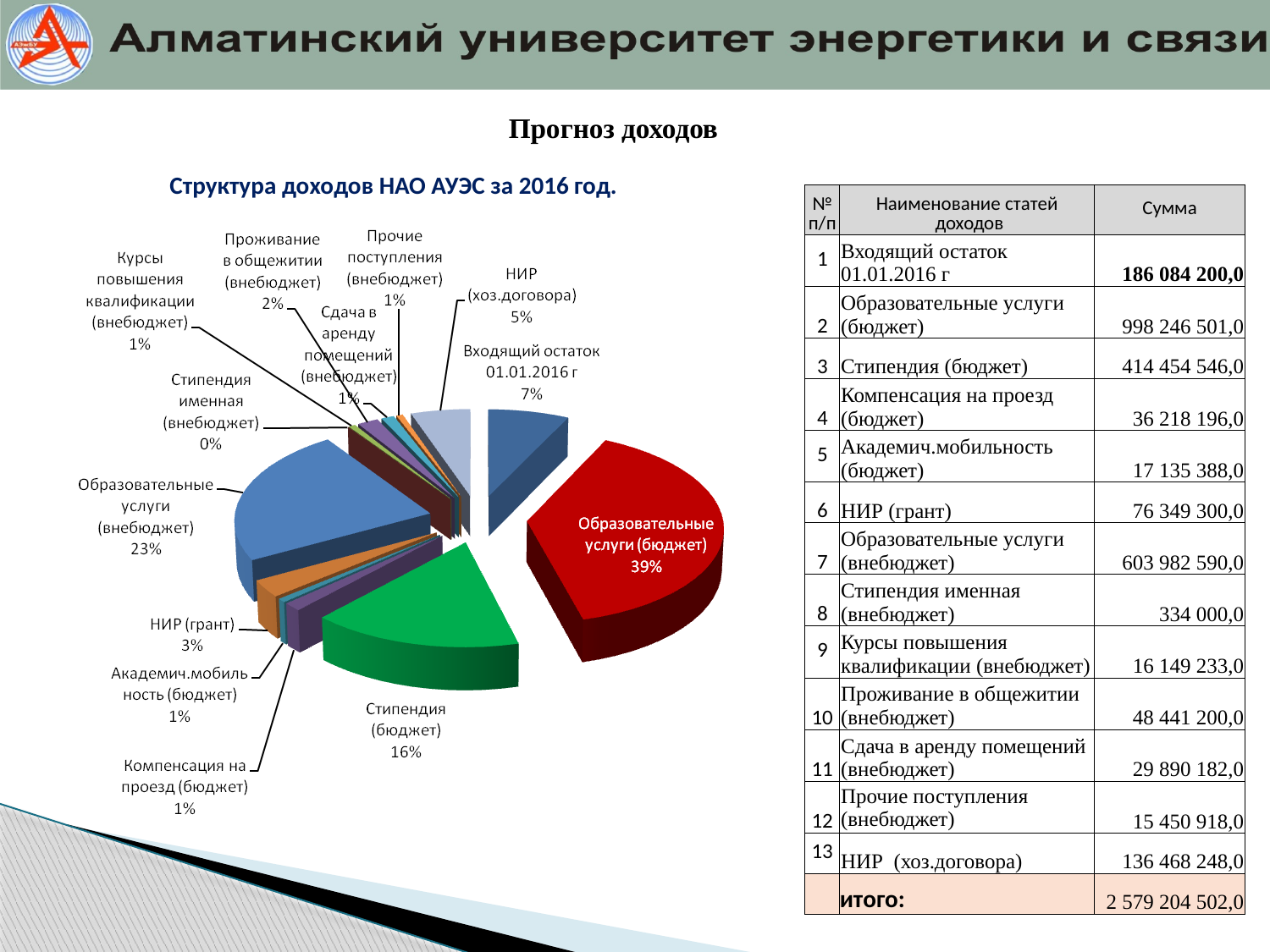
Which has the larger share: Стипендия (бюджет) or Образовательные услуги (внебюджет)? Образовательные услуги (внебюджет) Which slice of the pie is the smallest? Стипендия именная (внебюджет) What share of the pie does Образовательные услуги (бюджет) have? 39% What share of the pie does Образовательные услуги (внебюджет) have? 23% What is the title of the chart? Структура доходов НАО АУЭС за 2016 год. What share of the pie does НИР (грант) have? 3% How many percentage points larger is the share of Образовательные услуги (бюджет) than that of Образовательные услуги (внебюджет)? 16 Which slice of the pie is the largest? Образовательные услуги (бюджет) What kind of chart is shown on the slide? Pie chart